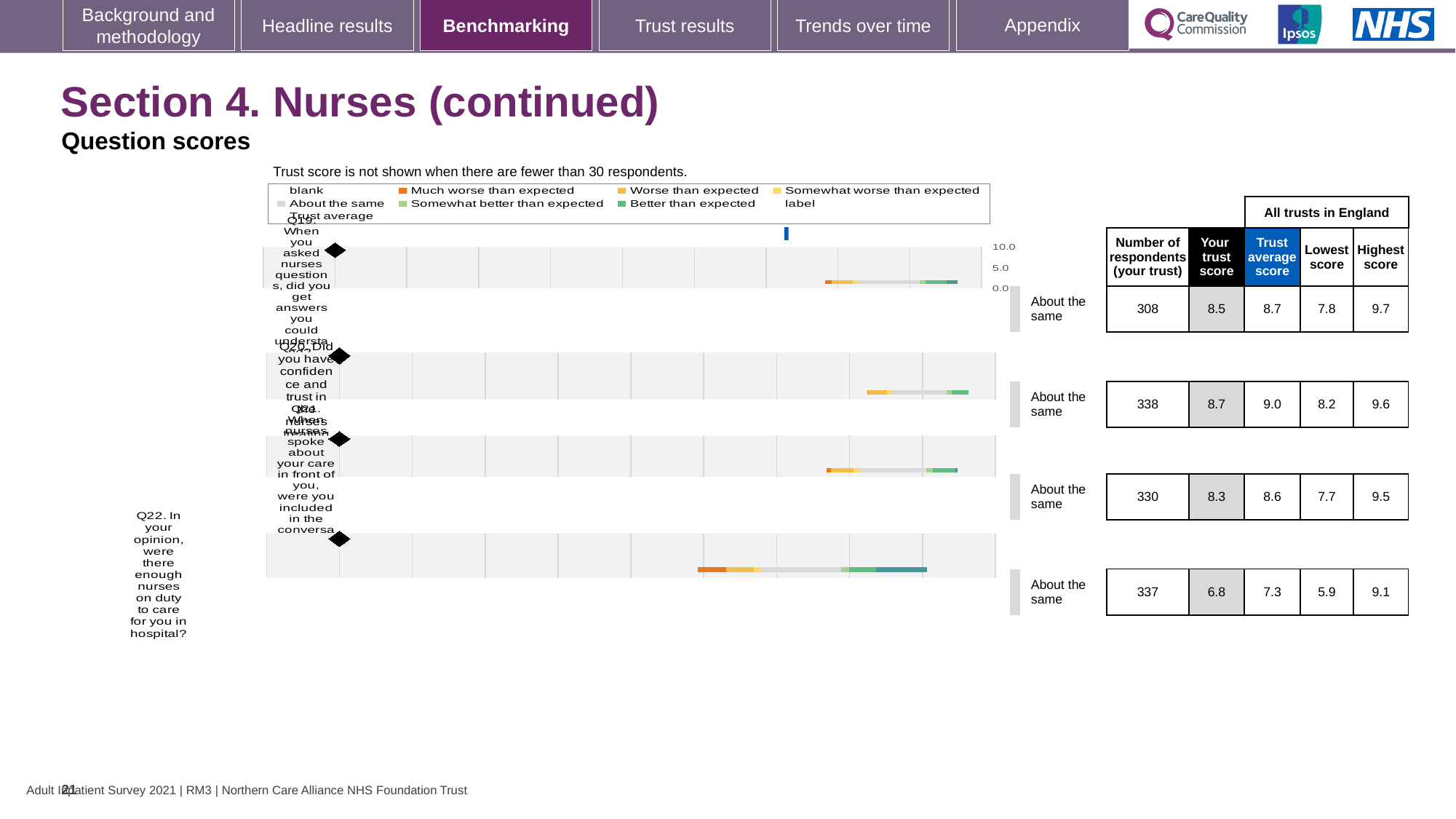
In the table, what is the number of respondents for Q20 (did you have confidence and trust in the nurses)? 338 In the table, what is the highest score across all trusts in England for Q21? 9.5 Which question has the lowest 'Your trust score' in the table? Q22 Is your trust score for Q19 larger or smaller than the trust average score for Q19? smaller What is the highest value shown on the chart's score axis? 10.0 How many questions (Q19 to Q22) are plotted in the chart? 4 Which question has the highest 'Your trust score' in the table? Q20 What benchmark category is shown for all four questions on this slide? About the same What is the difference between the trust average score and your trust score for Q22? 0.5 What kind of chart is used to show the question scores on this slide? bar chart In the table, what is the trust average score for Q22 (were there enough nurses on duty)? 7.3 In the table, what is the 'Your trust score' for Q19 (when you asked nurses questions, did you get answers you could understand)? 8.5